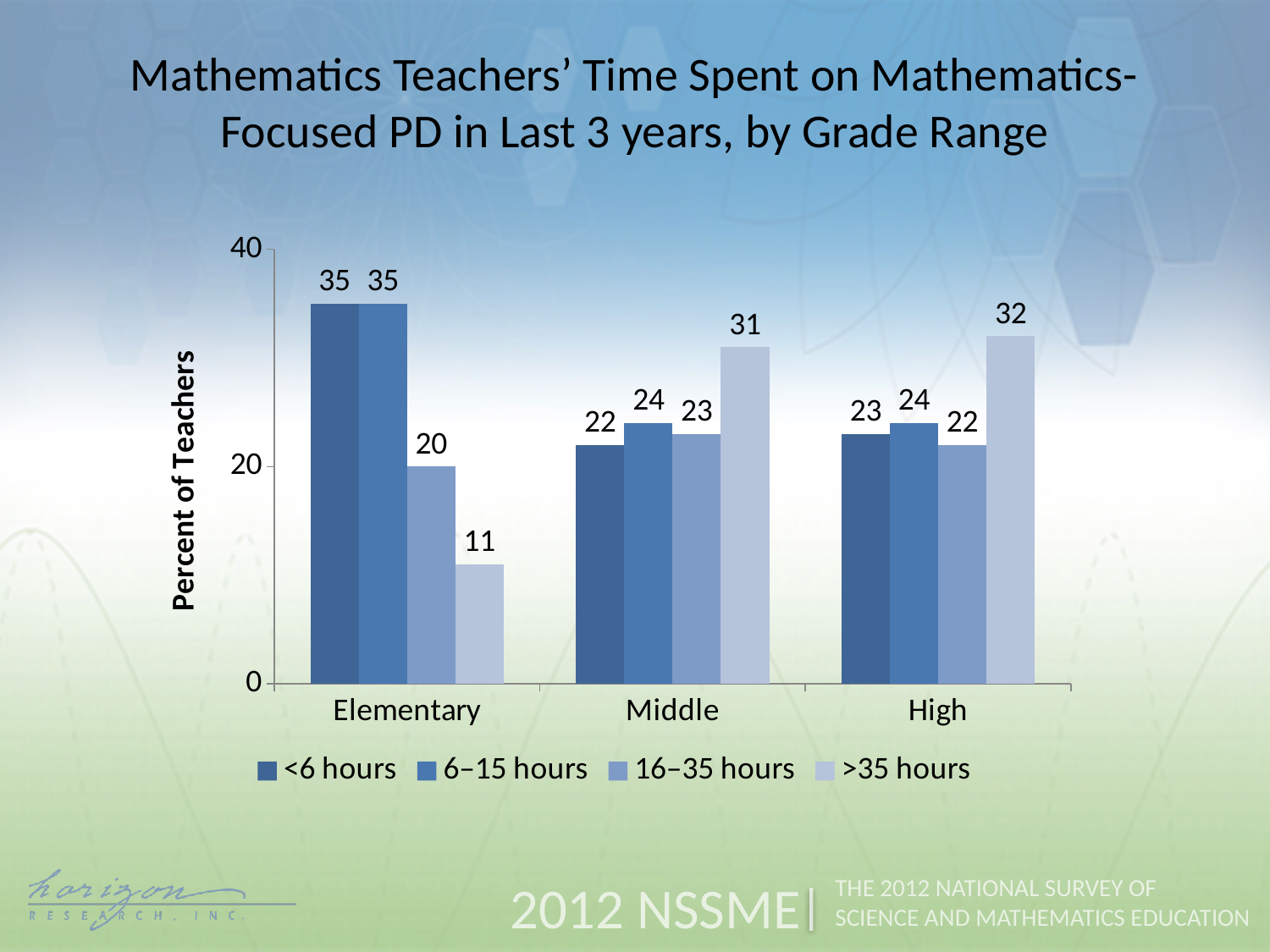
How many grade ranges are shown on the x axis? 3 What is the value for the 6–15 hours series in the Middle grade range? 24 Which grade range has the highest value for the >35 hours series? High What is the label of the y axis? Percent of Teachers Which grade range has the lowest value for the <6 hours series? Middle What kind of chart is shown on the slide? Bar chart Is the value for >35 hours in the High grade range greater or less than 20? greater What is the value for the 16–35 hours series in the High grade range? 22 How many series does the legend list? 4 What is the difference between the <6 hours value and the >35 hours value for Elementary? 24 What percent of elementary mathematics teachers spent >35 hours on mathematics-focused PD? 11 Which is larger for the Middle grade range: the <6 hours value or the >35 hours value? >35 hours